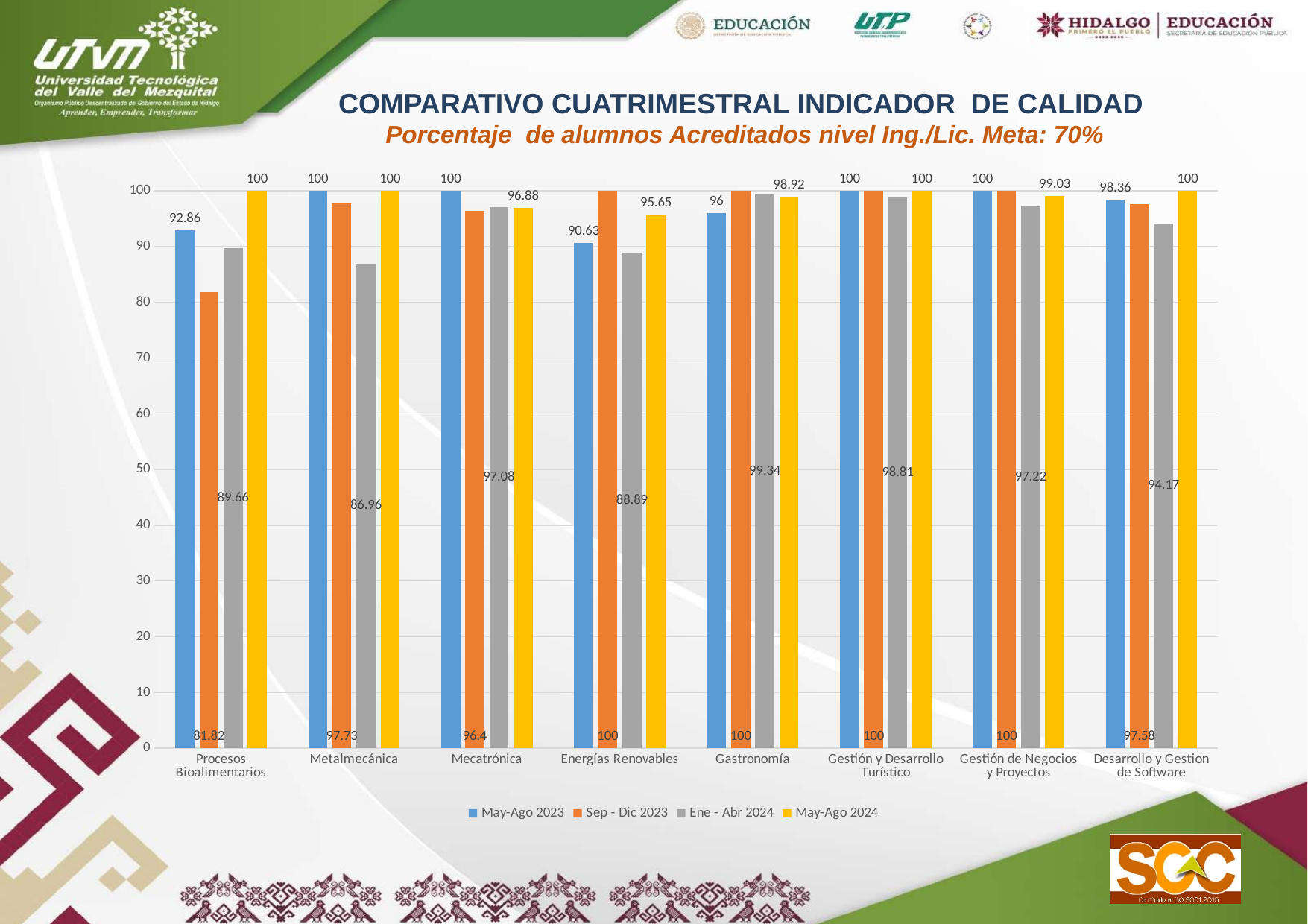
What is the May-Ago 2024 value for Energías Renovables? 95.65 Which category has the lowest Sep - Dic 2023 value? Procesos Bioalimentarios How many series does the legend list? 4 Is the Ene - Abr 2024 value for Energías Renovables greater or less than 90? less What is the Ene - Abr 2024 value for Metalmecánica? 86.96 What is the May-Ago 2023 value for Procesos Bioalimentarios? 92.86 What is the Sep - Dic 2023 value for Procesos Bioalimentarios? 81.82 What is the difference between the May-Ago 2024 and Sep - Dic 2023 values for Procesos Bioalimentarios? 18.18 What target (Meta) is stated in the chart subtitle? 70% How many program categories are shown on the x axis? 8 Which is larger for Energías Renovables: the May-Ago 2023 value or the Sep - Dic 2023 value? Sep - Dic 2023 What type of chart is shown on the slide? bar chart